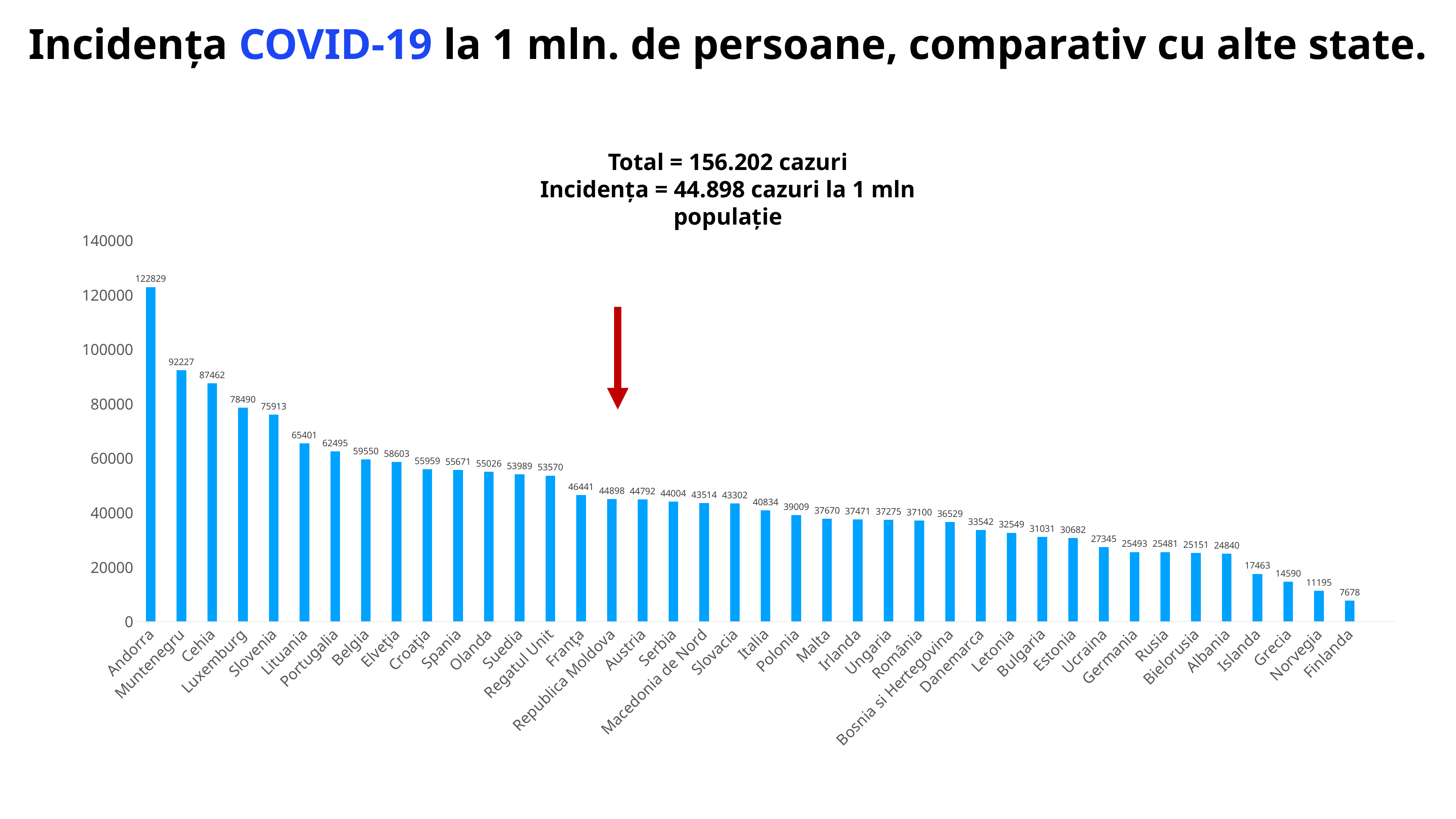
Which has a larger value, Muntenegru or Slovenia? Muntenegru Do the values rise or fall from left to right along the x axis? fall What kind of chart is shown on the slide? bar chart What is the value for Republica Moldova? 44898 What is the value for Andorra? 122829 What is the value for Germania? 25493 Which country has the lowest value? Finlanda What is the difference between the values for Andorra and Finlanda? 115151 Which country has the highest value? Andorra Is the value for Lituania greater or less than 60000? greater How many countries are shown in the chart? 40 What is the difference between the values for Cehia and Luxemburg? 8972